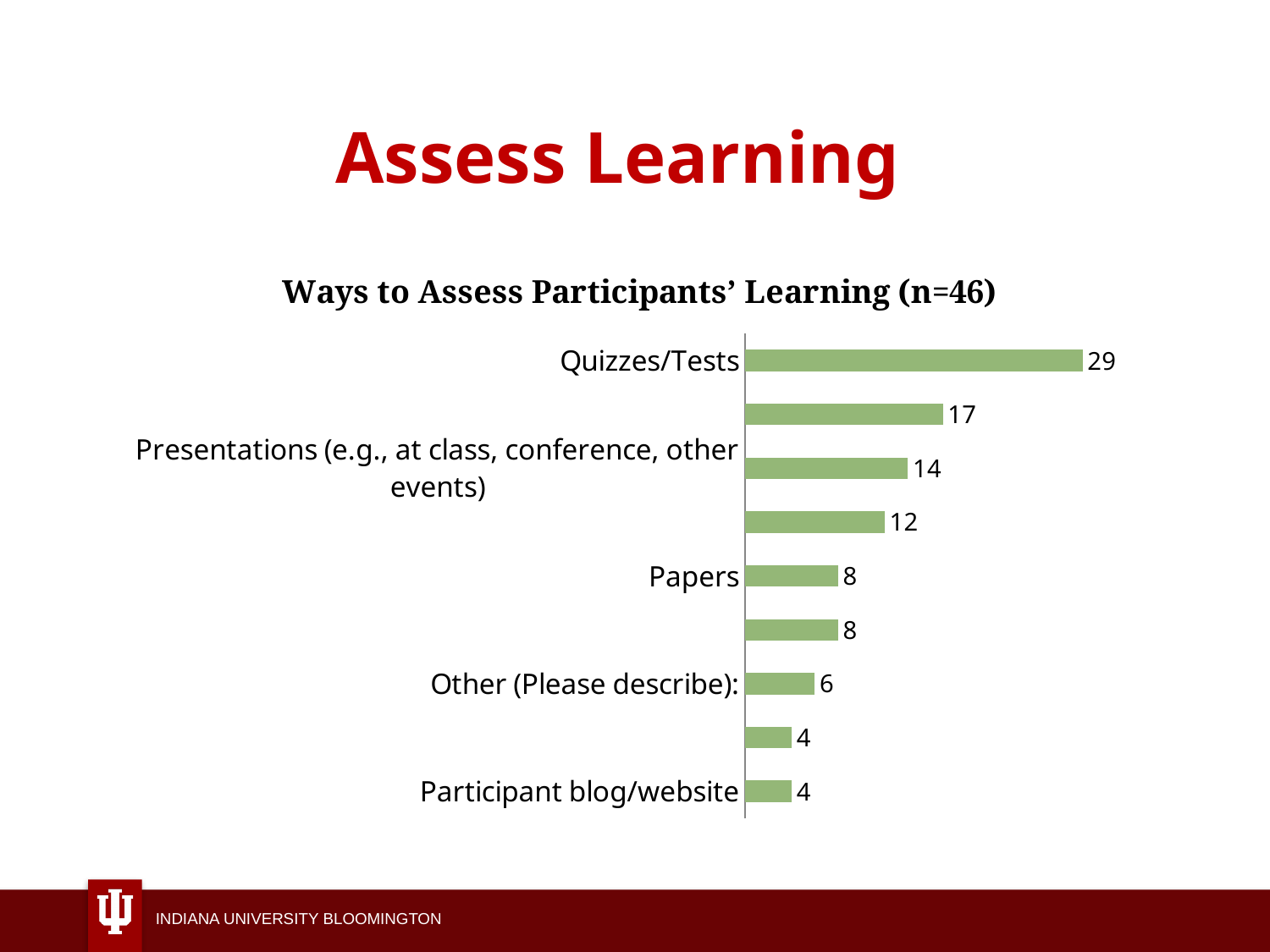
What type of chart is shown on the slide? bar chart What is the value for Papers? 8 What is the difference between the values for Papers and Participant blog/website? 4 Which category has the highest value? Quizzes/Tests What is the value for Presentations (e.g., at class, conference, other events)? 14 What is the value for Quizzes/Tests? 29 Which is larger, the value for Presentations or the value for Papers? Presentations What is the difference between the values for Quizzes/Tests and Papers? 21 What is the value for Other (Please describe):? 6 What is the value for Participant blog/website? 4 What is the title of the chart? Ways to Assess Participants' Learning (n=46) How many bars are plotted in the chart? 9